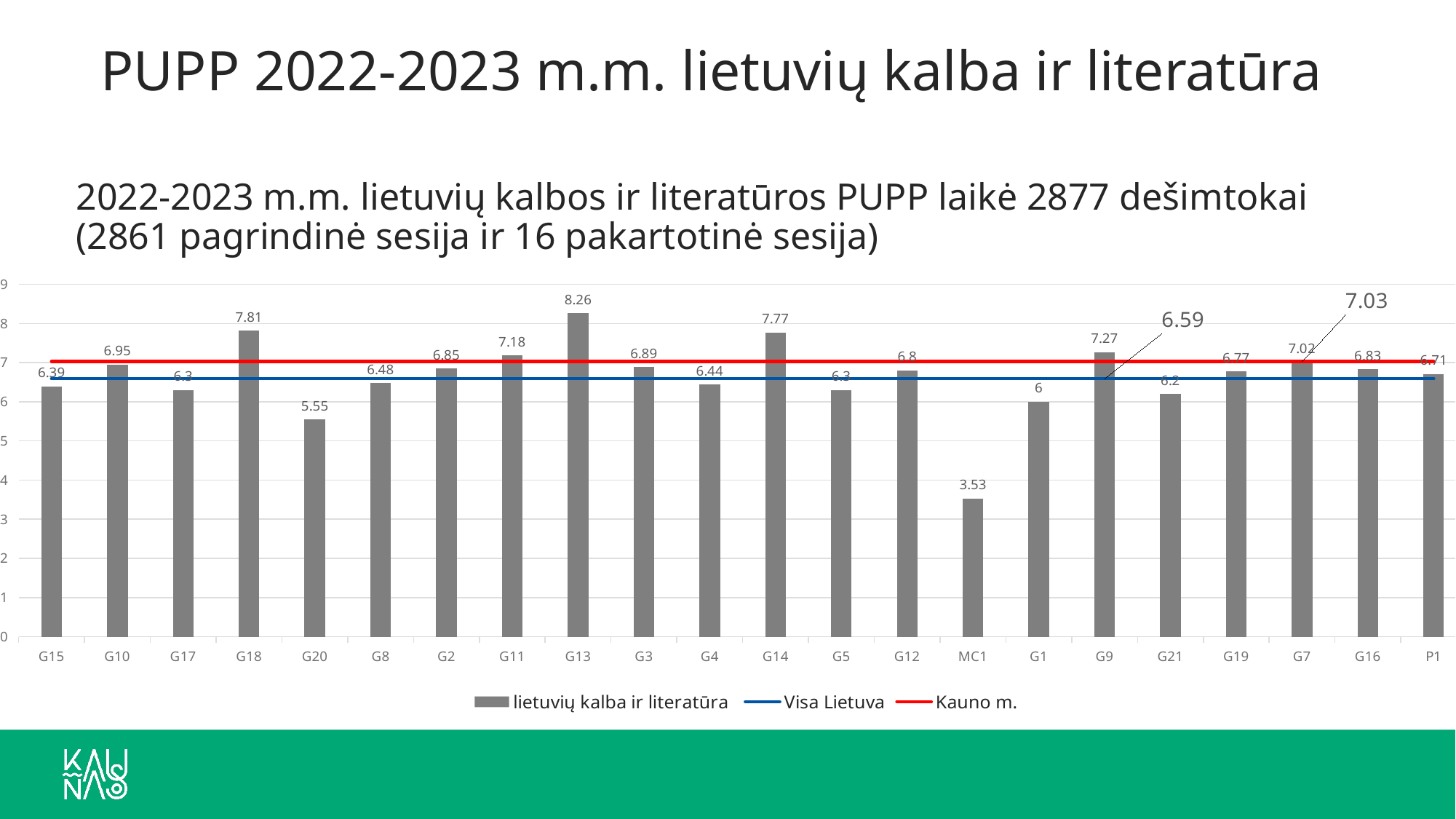
Which category has the highest bar? G13 What value is labelled on the Kauno m. line? 7.03 What is the value for G20? 5.55 What kind of chart is this? combination bar and line chart What is the value for MC1? 3.53 How many categories are shown on the x axis? 22 Which is larger, the value for G9 or the value for G11? G9 What value is labelled on the Visa Lietuva line? 6.59 What is the value for G13? 8.26 How many series does the legend list? 3 What is the difference between the values for G18 and G14? 0.04 Which category has the lowest bar? MC1